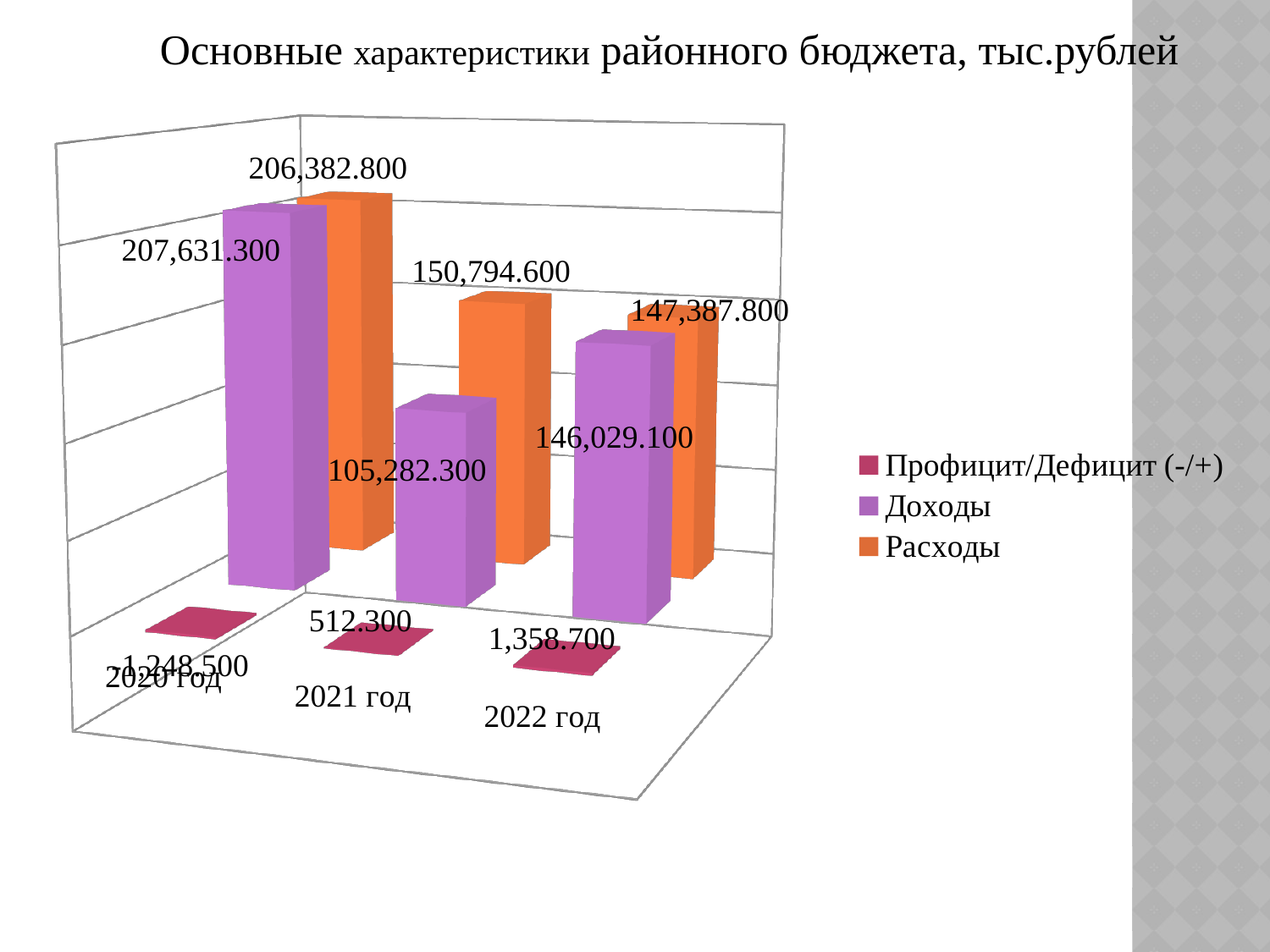
In which year is Доходы the lowest? 2021 год How many series does the legend list? 3 What is the value of Профицит/Дефицит (-/+) for 2022 год? 1,358.700 What is the value of Расходы for 2021 год? 150,794.600 What is the value of Расходы for 2022 год? 147,387.800 What is the value of Доходы for 2020 год? 207,631.300 What is the difference between Расходы in 2020 год and Расходы in 2022 год? 58,995.000 In which year is Доходы the highest? 2020 год For 2021 год, which is larger: Доходы or Расходы? Расходы How many years are shown on the x axis? 3 What is the value of Доходы for 2022 год? 146,029.100 What kind of chart is shown on the slide? bar chart